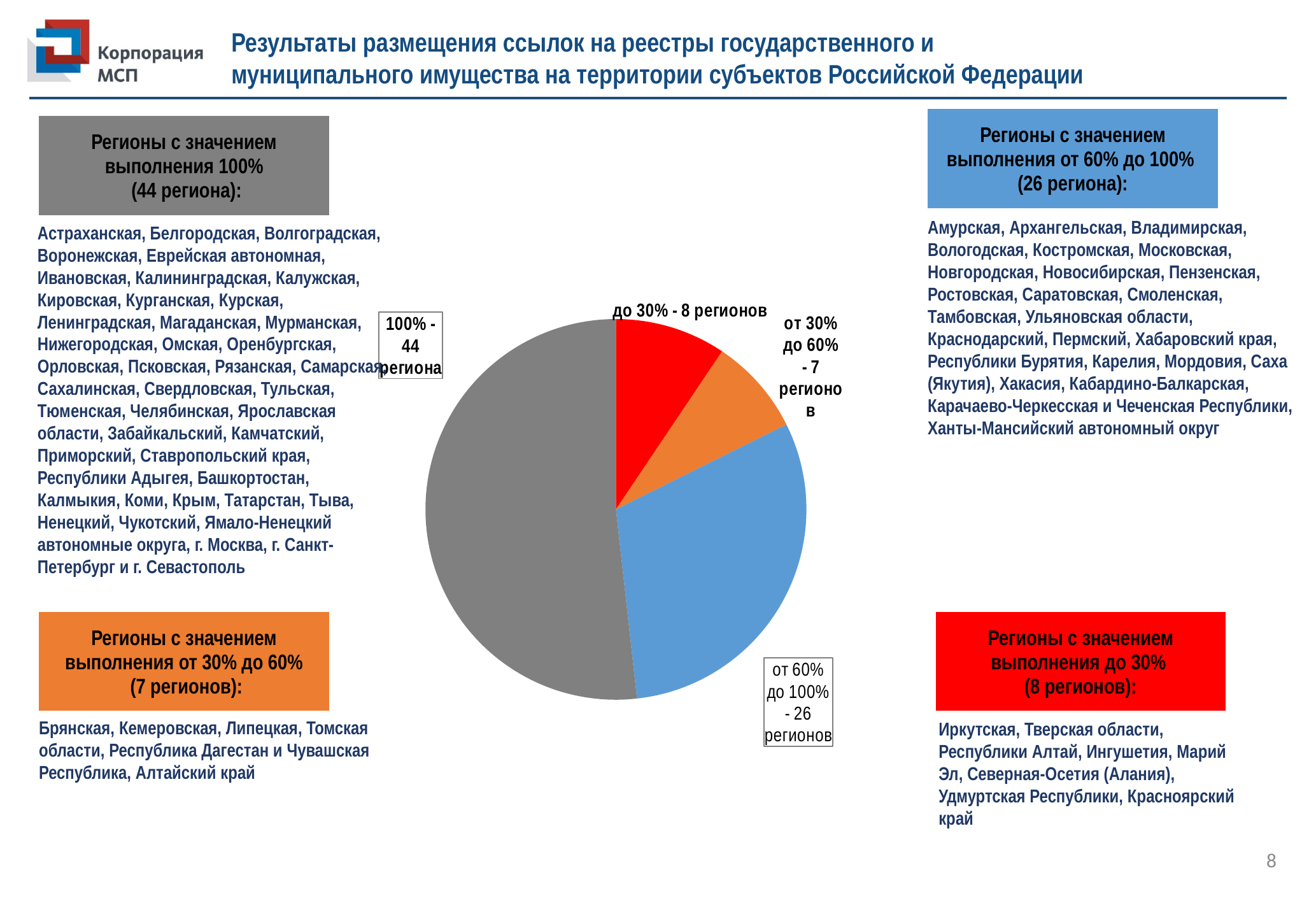
What kind of chart is shown in the centre of the slide? Pie chart How many more regions are in the '100%' slice than in the 'от 60% до 100%' slice? 18 Which slice of the pie chart represents the largest number of regions? 100% - 44 региона How many regions are in the 'от 30% до 60%' slice of the pie chart? 7 регионов How many slices does the pie chart have? 4 What is the total number of regions represented across all slices of the pie chart? 85 How many regions are in the 'до 30%' slice of the pie chart? 8 регионов What colour is the slice for regions with 100% execution in the pie chart? Grey Which slice of the pie chart represents the smallest number of regions? от 30% до 60% - 7 регионов How many regions are in the '100%' slice of the pie chart? 44 региона How many regions are in the 'от 60% до 100%' slice of the pie chart? 26 регионов Which slice has more regions: 'до 30%' or 'от 30% до 60%'? до 30%